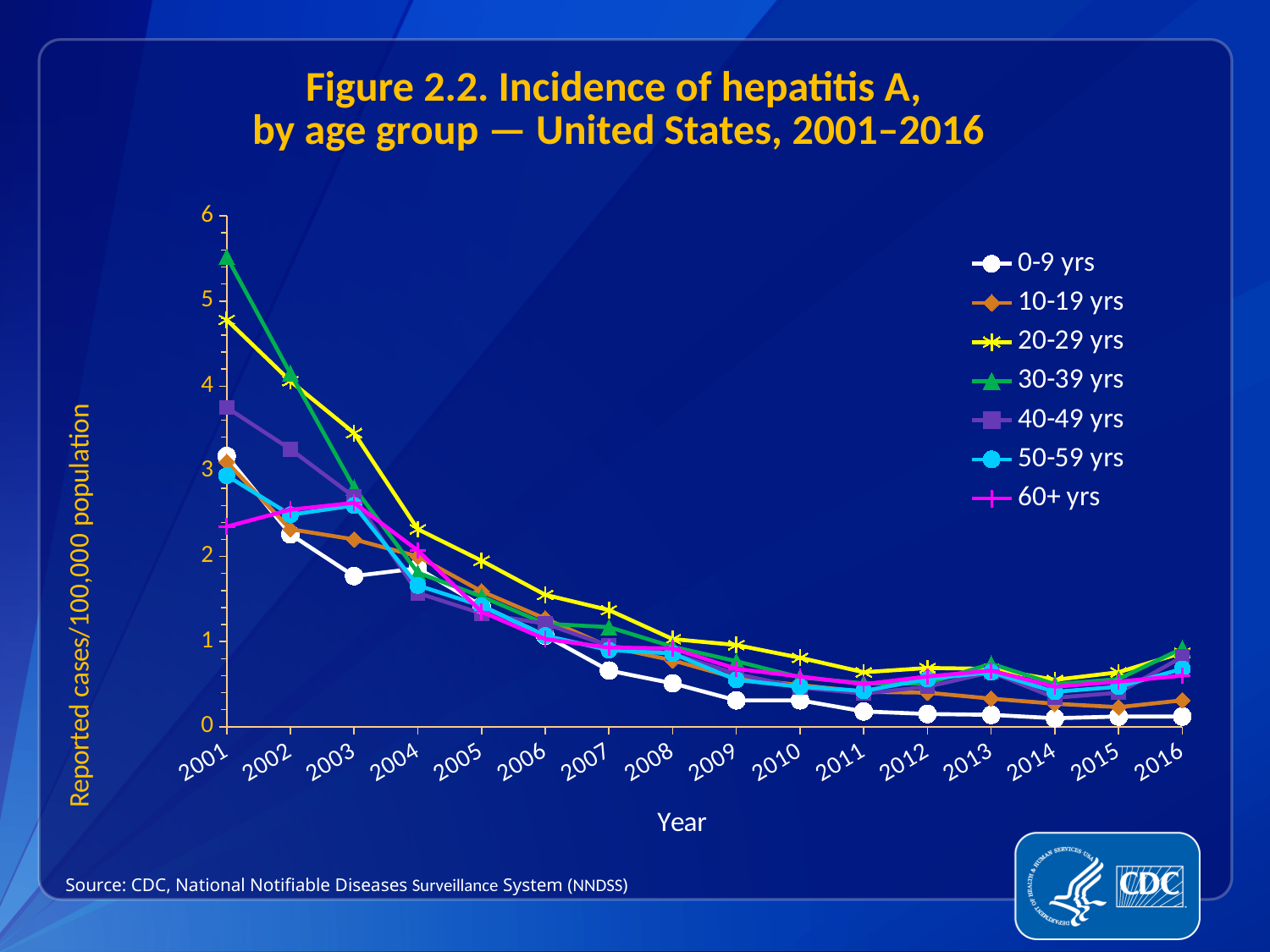
How many years are shown along the x axis? 16 Which age group had the lowest incidence of hepatitis A in 2016? 0-9 yrs What kind of chart is shown on the slide? line chart Is the value for the 0-9 yrs group in 2016 greater or less than 1? less In 2001, which had the higher incidence: the 30-39 yrs group or the 20-29 yrs group? 30-39 yrs How many age-group series does the legend list? 7 What is the label on the y axis? Reported cases/100,000 population Overall, do the incidence values rise or fall from 2001 to 2016? fall Which age group had the lowest incidence of hepatitis A in 2001? 60+ yrs Which age group had the highest incidence of hepatitis A in 2001? 30-39 yrs Is the value for the 30-39 yrs group in 2001 greater or less than 5? greater Is the value for the 20-29 yrs group in 2003 greater or less than 3? greater